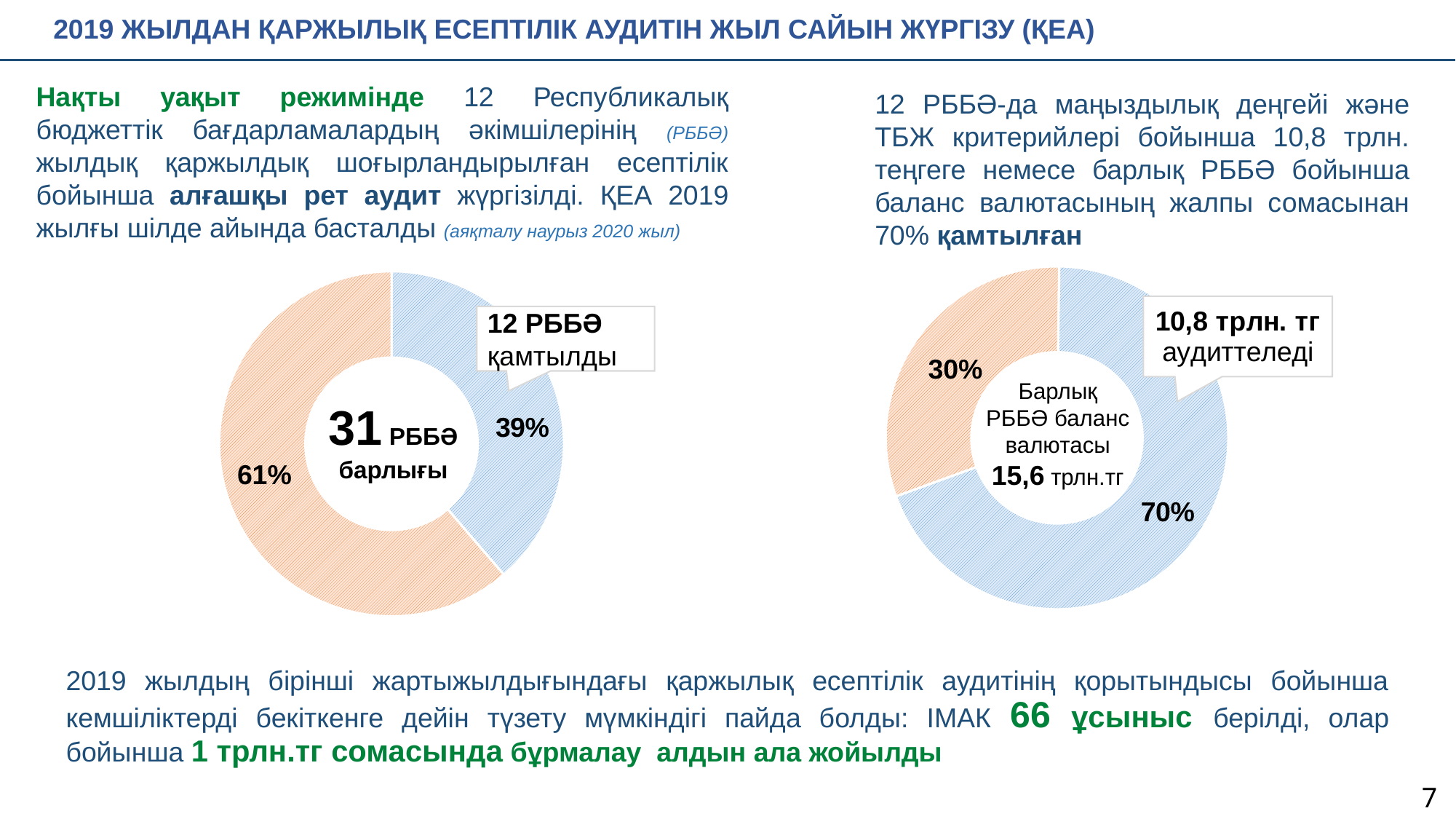
In the left chart, what total number of РББӘ is shown in the centre? 31 How many slices does the left chart have? 2 In the right chart, what is the difference between the 70% slice and the 30% slice? 40% In the right chart, what share is labelled for the blue slice (10,8 трлн. тг аудиттеледі)? 70% What kind of chart is the left chart on the slide? Pie (donut) chart In the left chart, which slice is larger, the 39% slice or the 61% slice? The 61% slice In the right chart, what share is labelled for the orange slice? 30% In the left chart, what is the difference between the two slice percentages? 22% In the left chart, what share is labelled for the orange slice? 61% In the right chart, what total balance currency value is shown in the centre? 15,6 трлн.тг In the right chart, what value is given in the callout for the audited portion? 10,8 трлн. тг